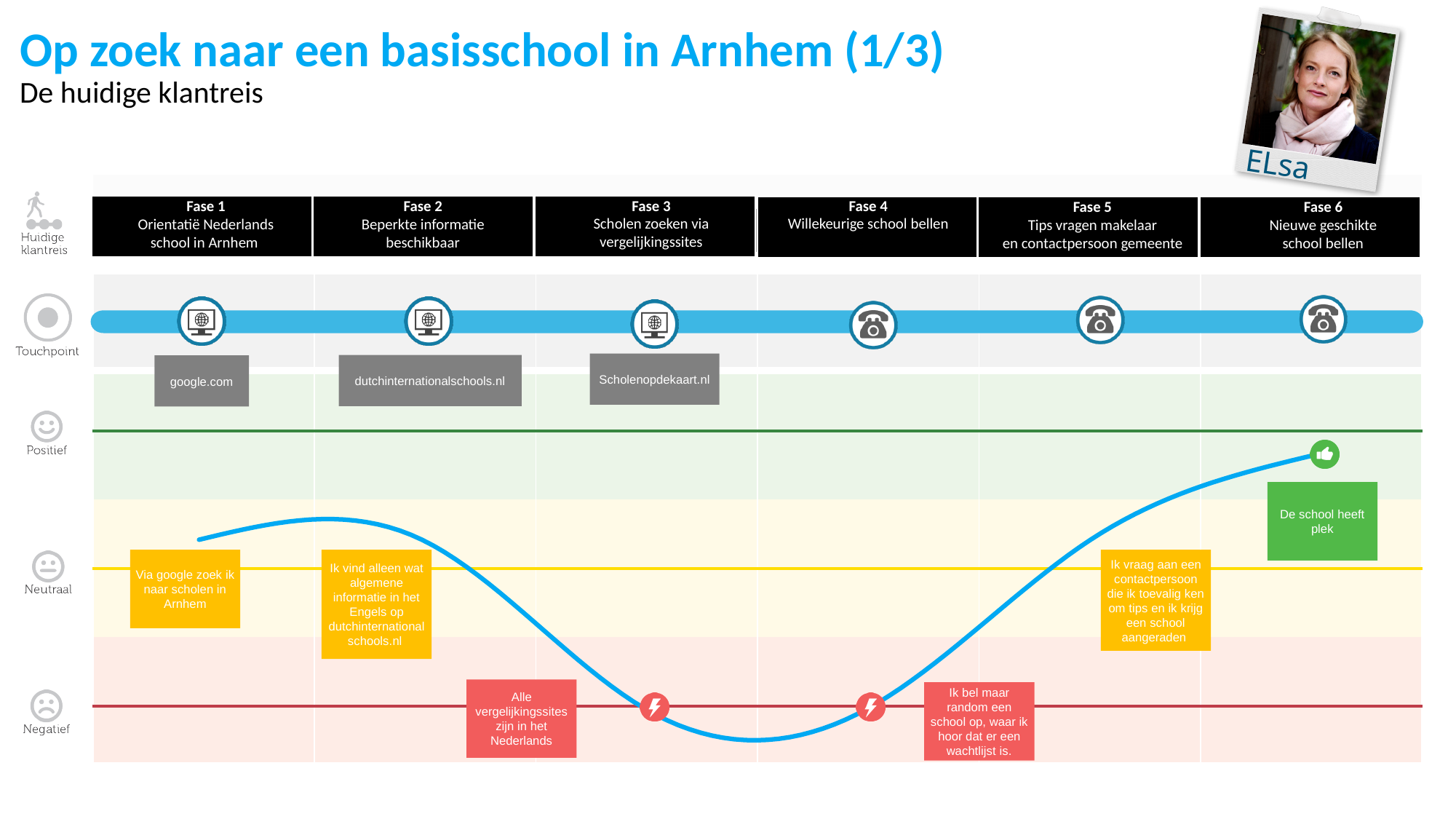
Which website is the touchpoint in Fase 1? google.com How many touchpoint icons are shown on the blue touchpoint line? 6 Does the emotion curve rise or fall between Fase 2 and Fase 3? Fall In which phases does the emotion curve reach the Negatief line? Fase 3 and Fase 4 What text is in the green box in Fase 6? De school heeft plek Does the emotion curve rise or fall from Fase 4 to Fase 6? Rise Which phase has the highest (most positive) point of the emotion curve? Fase 6 What is the name of Fase 4? Willekeurige school bellen How many phases (Fase) are shown along the top of the customer journey? 6 What are the three emotion levels labelled on the left side of the journey map? Positief, Neutraal, Negatief Is the emotion curve in Fase 1 above or below the Neutraal line? Above Which website is the touchpoint in Fase 3? Scholenopdekaart.nl